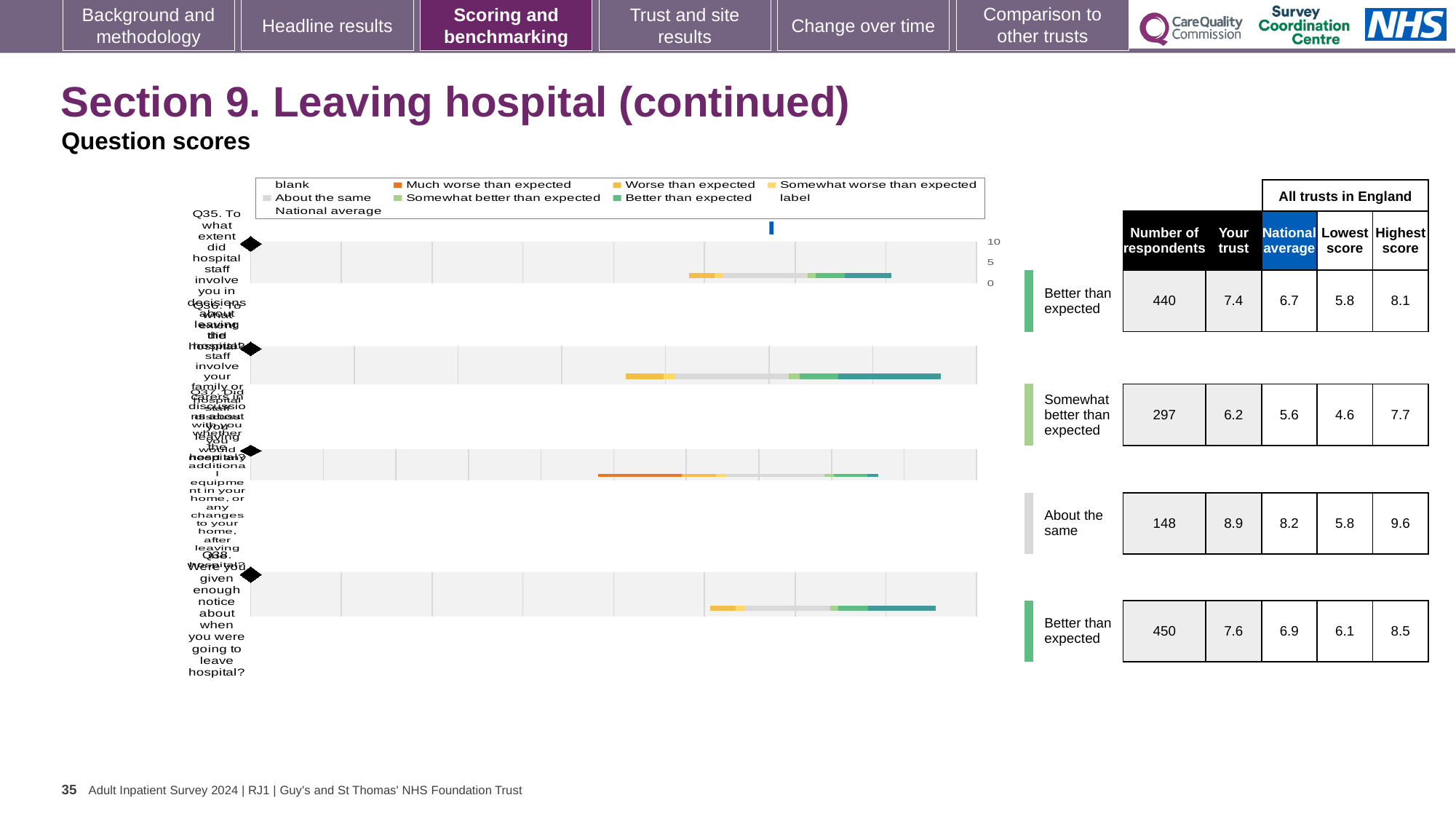
What is the 'Your trust' score for Q35 (involving you in decisions about leaving hospital)? 7.4 For Q38, which is larger: the trust's score or the national average? Your trust (7.6) How many questions (bars) are plotted in the chart? 4 By how much does the trust's score for Q35 exceed the national average? 0.7 What is the lowest score among all trusts in England for the second question from the top? 4.6 What is the national average score for Q35? 6.7 Which question row has the fewest respondents? the third question from the top (148) Which question row has the highest 'Your trust' score? the third question from the top (8.9) How many respondents answered Q38 (enough notice about when you were going to leave hospital)? 450 What benchmark category is shown for Q35? Better than expected What kind of chart is shown on the slide? bar chart What is the highest score among all trusts in England for Q38? 8.5